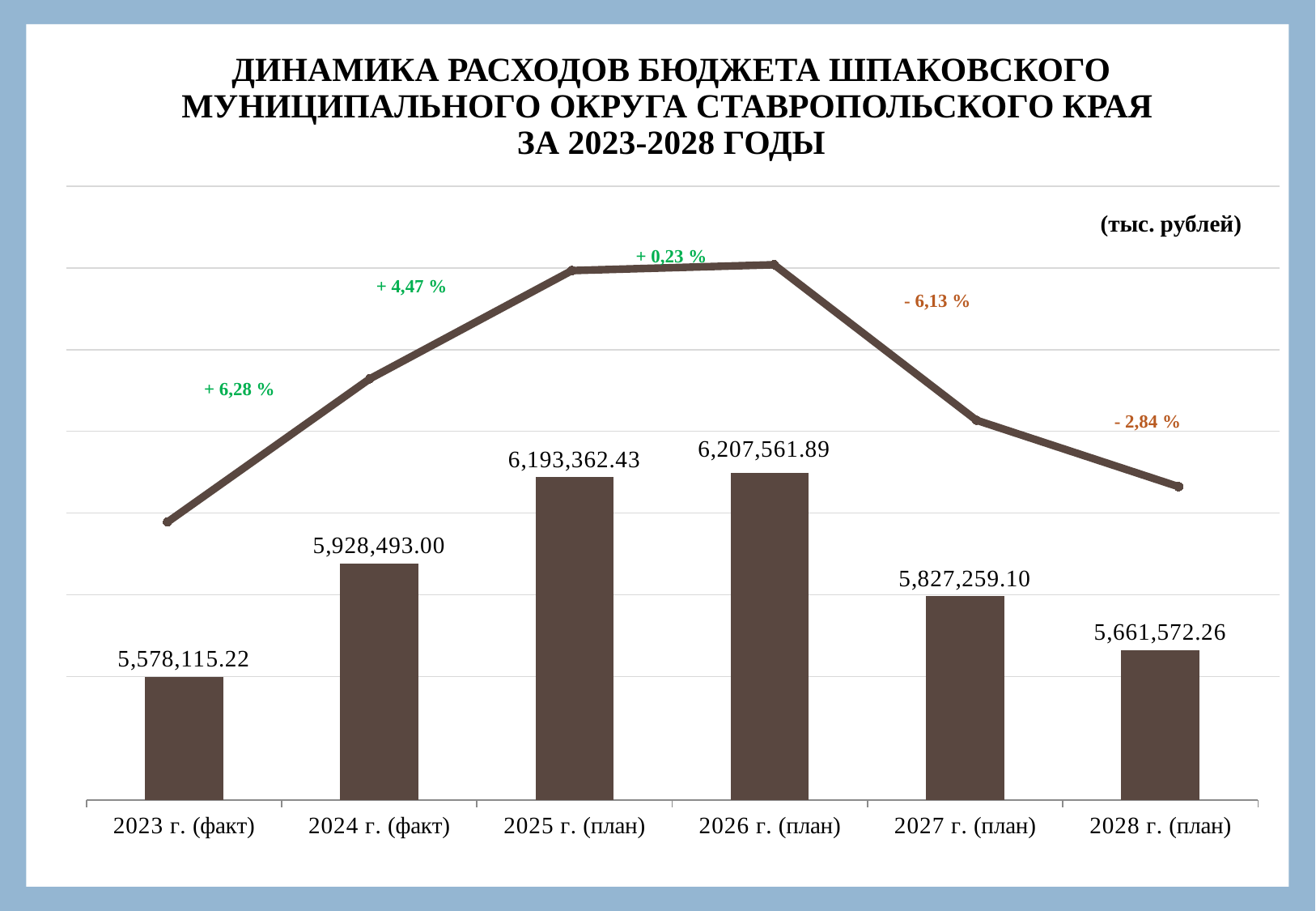
Which year has the highest expenditure value? 2026 г. (план) How many years (categories) are shown on the x axis? 6 What kind of chart is used to show the expenditure values? Bar chart What is the budget expenditure value for 2023 г. (факт)? 5,578,115.22 What is the difference between the values for 2024 г. (факт) and 2023 г. (факт)? 350,377.78 Which is larger, the value for 2025 г. (план) or the value for 2027 г. (план)? 2025 г. (план) What is the value shown for 2026 г. (план)? 6,207,561.89 Which year has the lowest expenditure value? 2023 г. (факт) What percentage change is labelled between 2026 г. (план) and 2027 г. (план)? - 6,13 % In what units are the values expressed, according to the label on the chart? тыс. рублей What is the value shown for 2028 г. (план)? 5,661,572.26 What is the difference between the values for 2027 г. (план) and 2028 г. (план)? 165,686.84